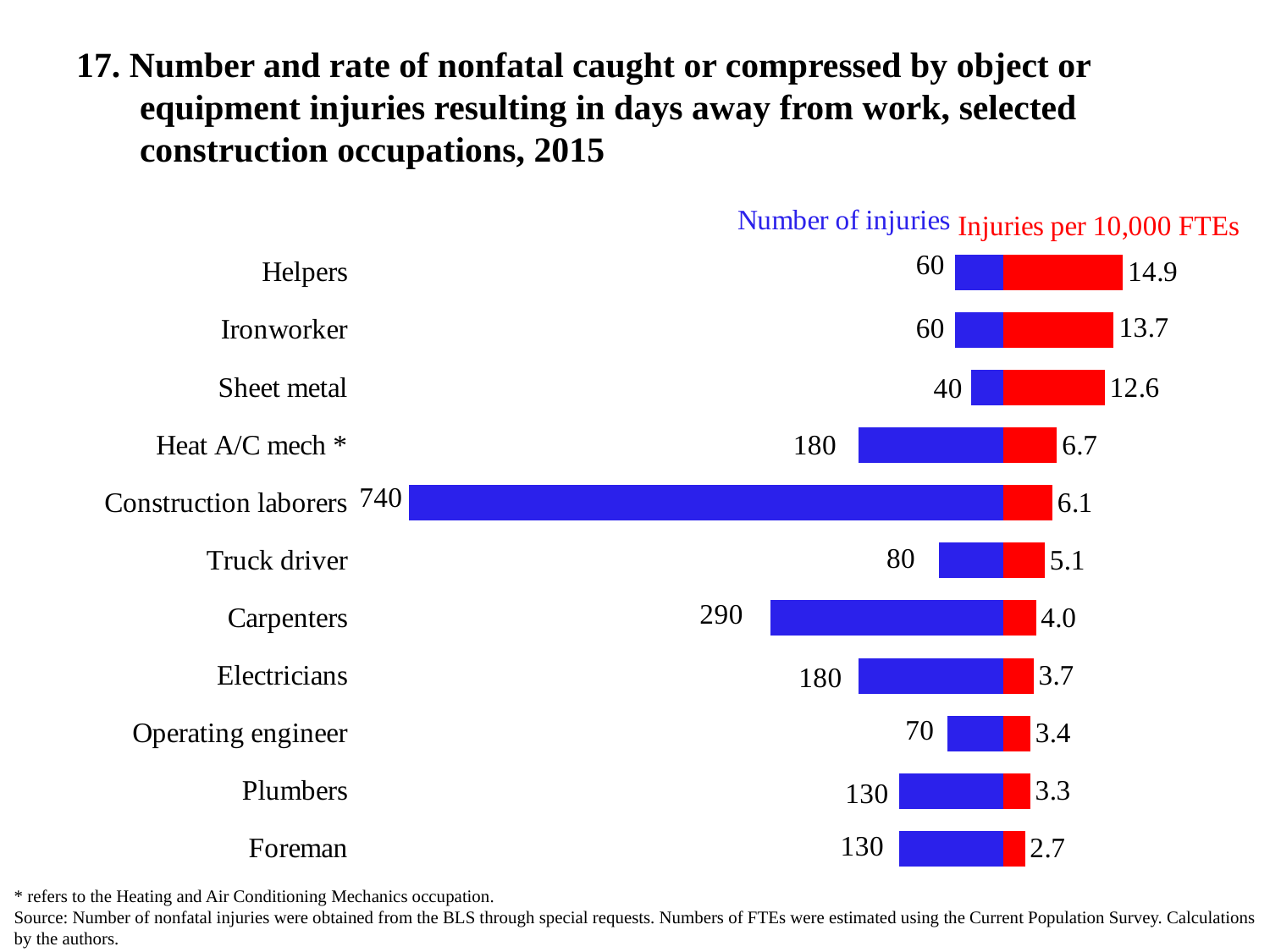
How many data series does the chart show? 2 What is the difference in number of injuries between Construction laborers and Carpenters? 450 What is the number of injuries for Carpenters? 290 What is the difference in injury rate per 10,000 FTEs between Helpers and Ironworker? 1.2 Which has a higher injury rate per 10,000 FTEs, Truck driver or Carpenters? Truck driver Which occupation has the lowest injury rate per 10,000 FTEs? Foreman Which occupation has the lowest number of injuries? Sheet metal Which occupation has the highest number of injuries? Construction laborers How many occupations are shown in the chart? 11 What is the injury rate per 10,000 FTEs for Helpers? 14.9 What is the injury rate per 10,000 FTEs for Foreman? 2.7 What is the number of injuries for Construction laborers? 740